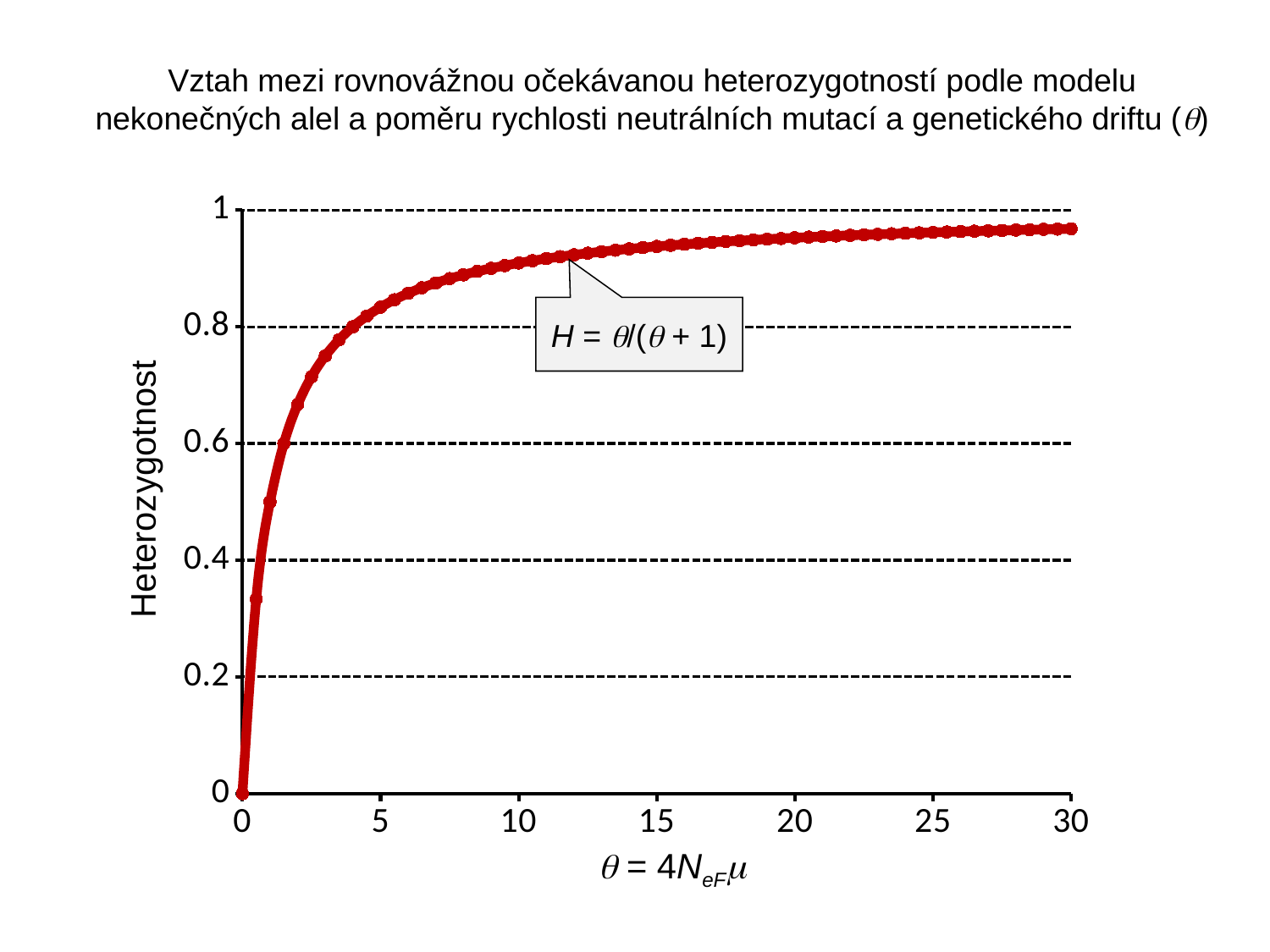
What is the label of the y axis? Heterozygotnost Is the value of heterozygotnost at θ = 30 greater or less than 0.8? greater Which is larger, the heterozygotnost at θ = 5 or at θ = 25? θ = 25 Is the value of heterozygotnost at θ = 2 greater or less than 0.6? greater Is the value of heterozygotnost at θ = 10 greater or less than 1? less What kind of chart is shown on the slide? line chart What formula is shown in the callout box on the chart? H = θ/(θ + 1) Does heterozygotnost rise or fall as θ increases along the x axis? rises What is the value of heterozygotnost at θ = 0? 0 At which value of θ shown on the x axis is heterozygotnost lowest? 0